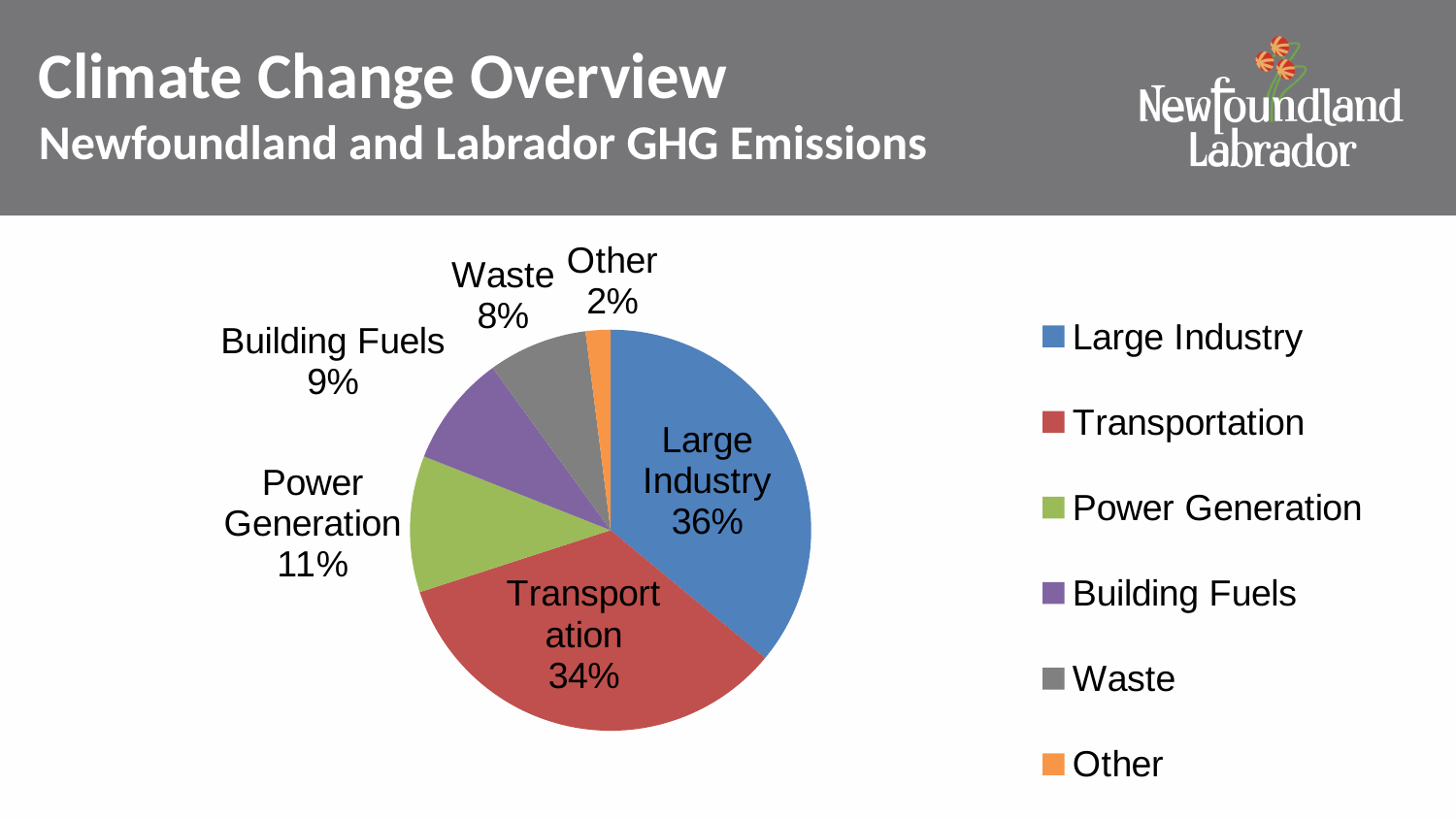
What share of GHG emissions comes from Transportation? 34% What colour is the Transportation slice? Red What is the difference in percentage points between Large Industry and Transportation? 2 What kind of chart is shown on the slide? Pie chart How many categories are shown in the pie chart? 6 What share of GHG emissions comes from Building Fuels? 9% Which category has the largest share of emissions? Large Industry What share of GHG emissions comes from Waste? 8% What share of GHG emissions comes from Power Generation? 11% Which is larger, the share for Power Generation or the share for Waste? Power Generation What share of GHG emissions comes from Large Industry? 36% Which category has the smallest share of emissions? Other